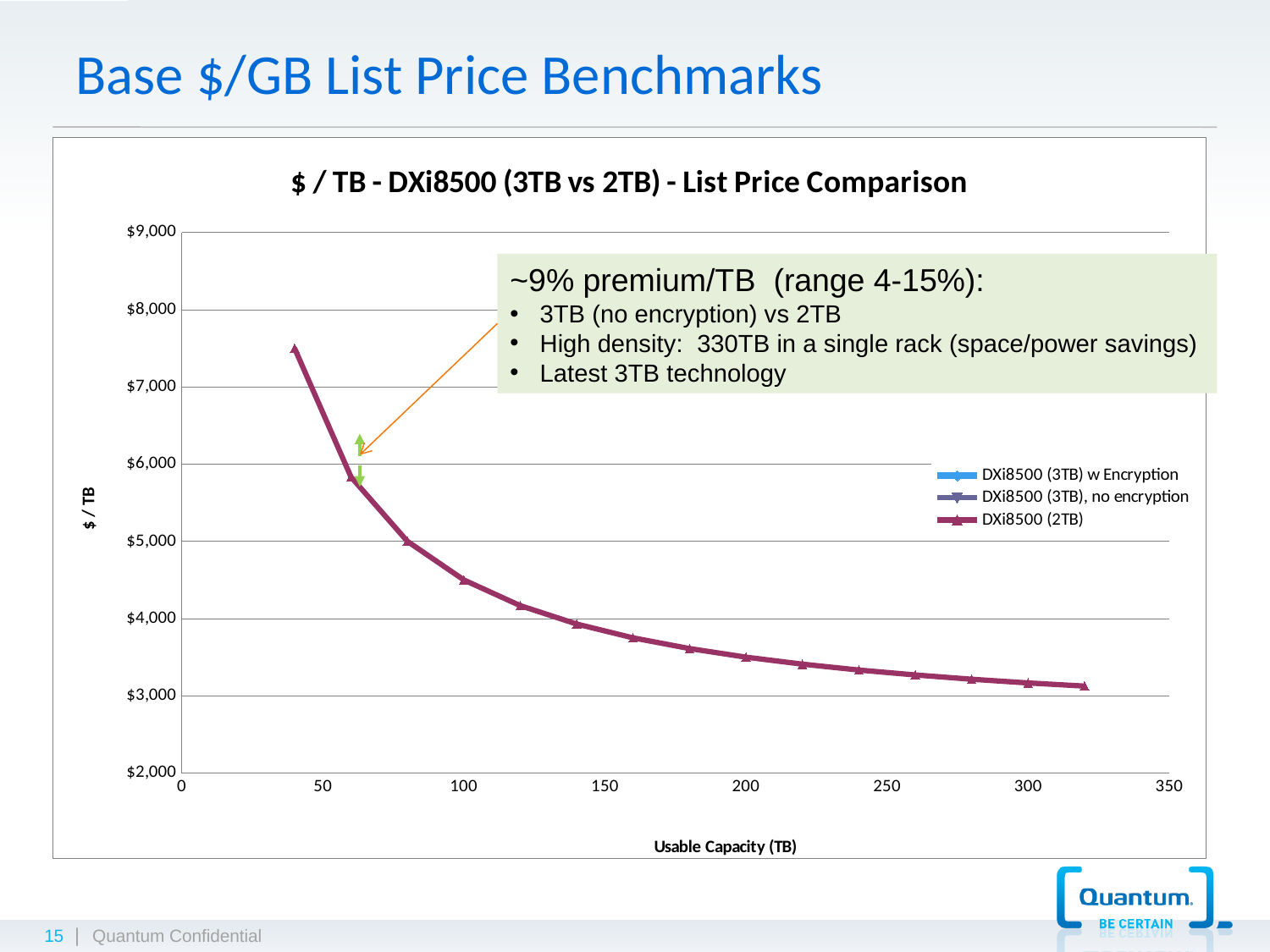
Is the $/TB value for DXi8500 (2TB) at 40 TB greater or less than $7,000? greater At which usable capacity is the $/TB value for DXi8500 (2TB) lowest? 320 What kind of chart is shown on the slide? line chart Which has the larger $/TB value for DXi8500 (2TB): 60 TB or 300 TB? 60 TB What is the label of the x axis? Usable Capacity (TB) Is the $/TB value for DXi8500 (2TB) at 200 TB greater or less than $4,000? less Is the $/TB value for DXi8500 (2TB) at 100 TB greater or less than $5,000? less How many series does the chart legend list? 3 Do the $/TB values rise or fall as usable capacity increases? fall What is the title of the chart? $ / TB - DXi8500 (3TB vs 2TB) - List Price Comparison At which usable capacity is the $/TB value for DXi8500 (2TB) highest? 40